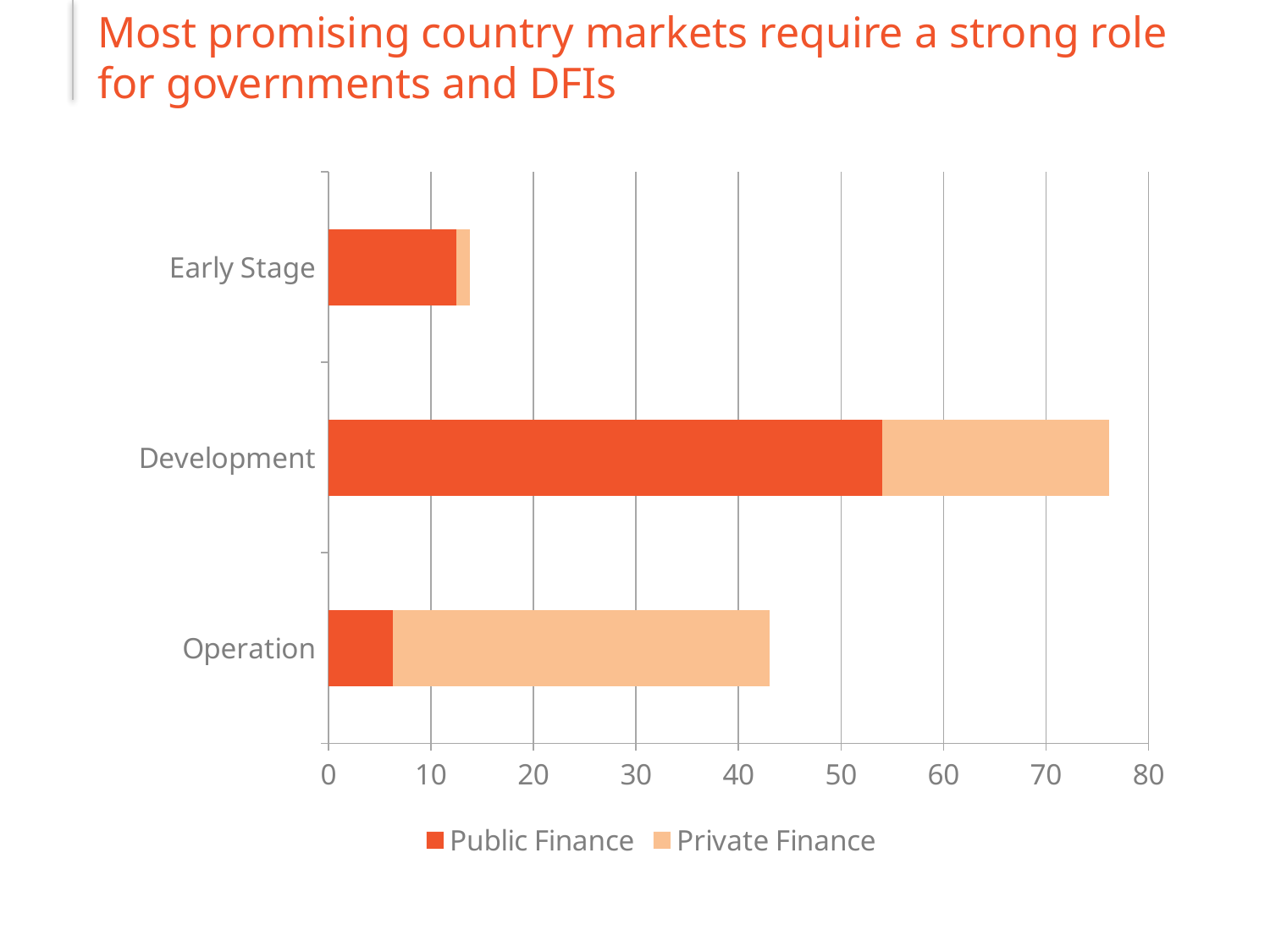
Which category has the longest total bar? Development How many categories are shown on the vertical axis of the chart? 3 Which series is shown in the darker orange colour in the legend? Public Finance Is the total bar length for Development greater or less than 70? greater Is the Public Finance value for Development greater or less than 50? greater Which category has the shortest total bar? Early Stage What kind of chart is shown on the slide? stacked bar chart How many series does the chart legend list? 2 Which is larger, the Private Finance segment for Operation or the Private Finance segment for Early Stage? Operation Is the Public Finance value for Operation greater or less than 10? less Which is larger, the Public Finance segment for Development or the Public Finance segment for Operation? Development